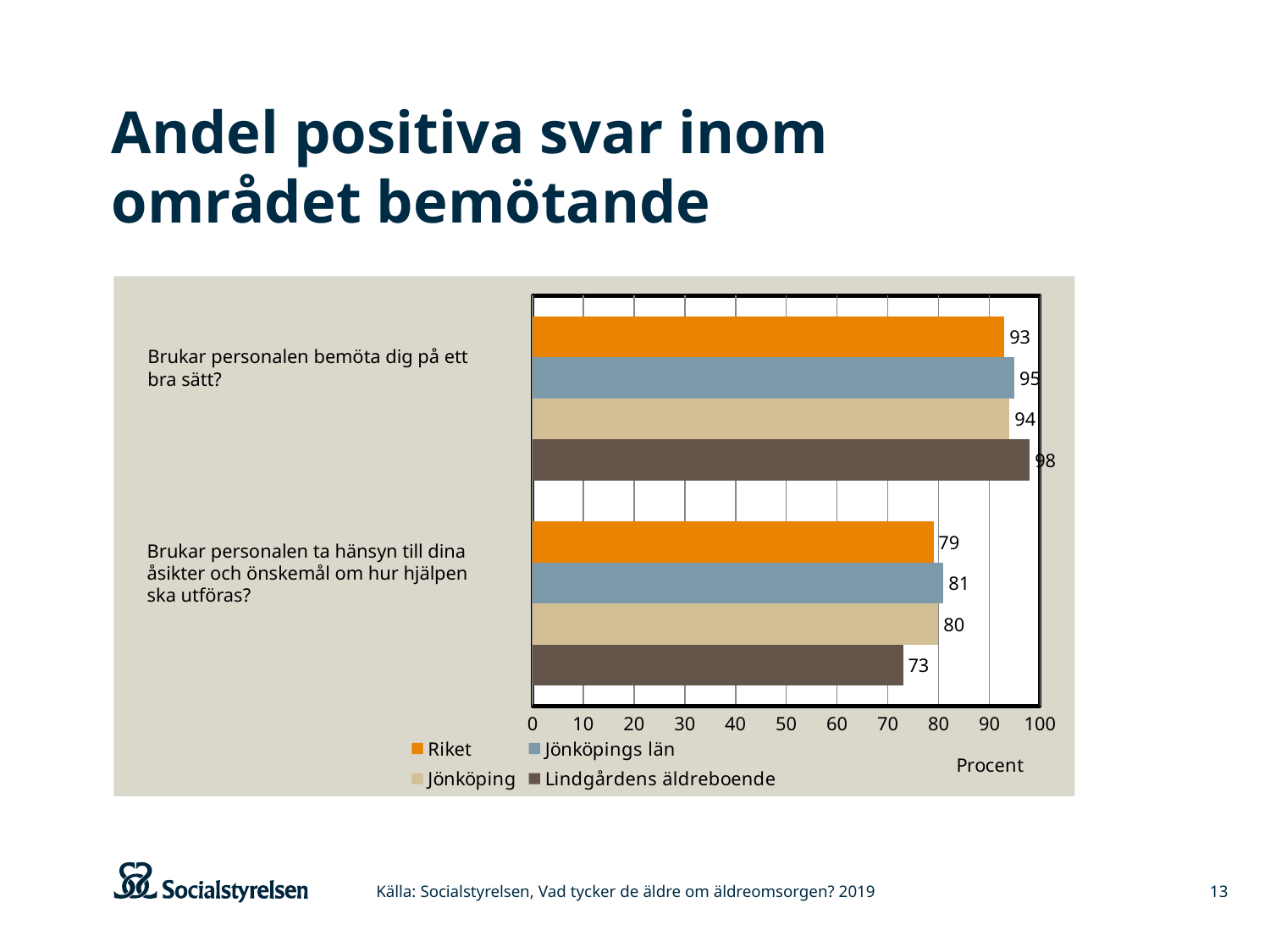
What is the difference between the Lindgårdens äldreboende value and the Riket value for the question "Brukar personalen bemöta dig på ett bra sätt?"? 5 What is the value for Riket for the question "Brukar personalen ta hänsyn till dina åsikter och önskemål om hur hjälpen ska utföras?"? 79 Which series has the lowest value for the question "Brukar personalen ta hänsyn till dina åsikter och önskemål om hur hjälpen ska utföras?"? Lindgårdens äldreboende Which series has the highest value for the question "Brukar personalen bemöta dig på ett bra sätt?"? Lindgårdens äldreboende How many series does the legend list? 4 What is the difference between the Jönköpings län value and the Lindgårdens äldreboende value for the question "Brukar personalen ta hänsyn till dina åsikter och önskemål om hur hjälpen ska utföras?"? 8 For Lindgårdens äldreboende, which question has the larger value: "Brukar personalen bemöta dig på ett bra sätt?" or "Brukar personalen ta hänsyn till dina åsikter och önskemål om hur hjälpen ska utföras?"? Brukar personalen bemöta dig på ett bra sätt? What is the value for Lindgårdens äldreboende for the question "Brukar personalen bemöta dig på ett bra sätt?"? 98 What kind of chart is shown on the slide? Bar chart What unit is shown on the horizontal axis label of the chart? Procent What is the value for Jönköping for the question "Brukar personalen ta hänsyn till dina åsikter och önskemål om hur hjälpen ska utföras?"? 80 What is the value for Jönköpings län for the question "Brukar personalen bemöta dig på ett bra sätt?"? 95